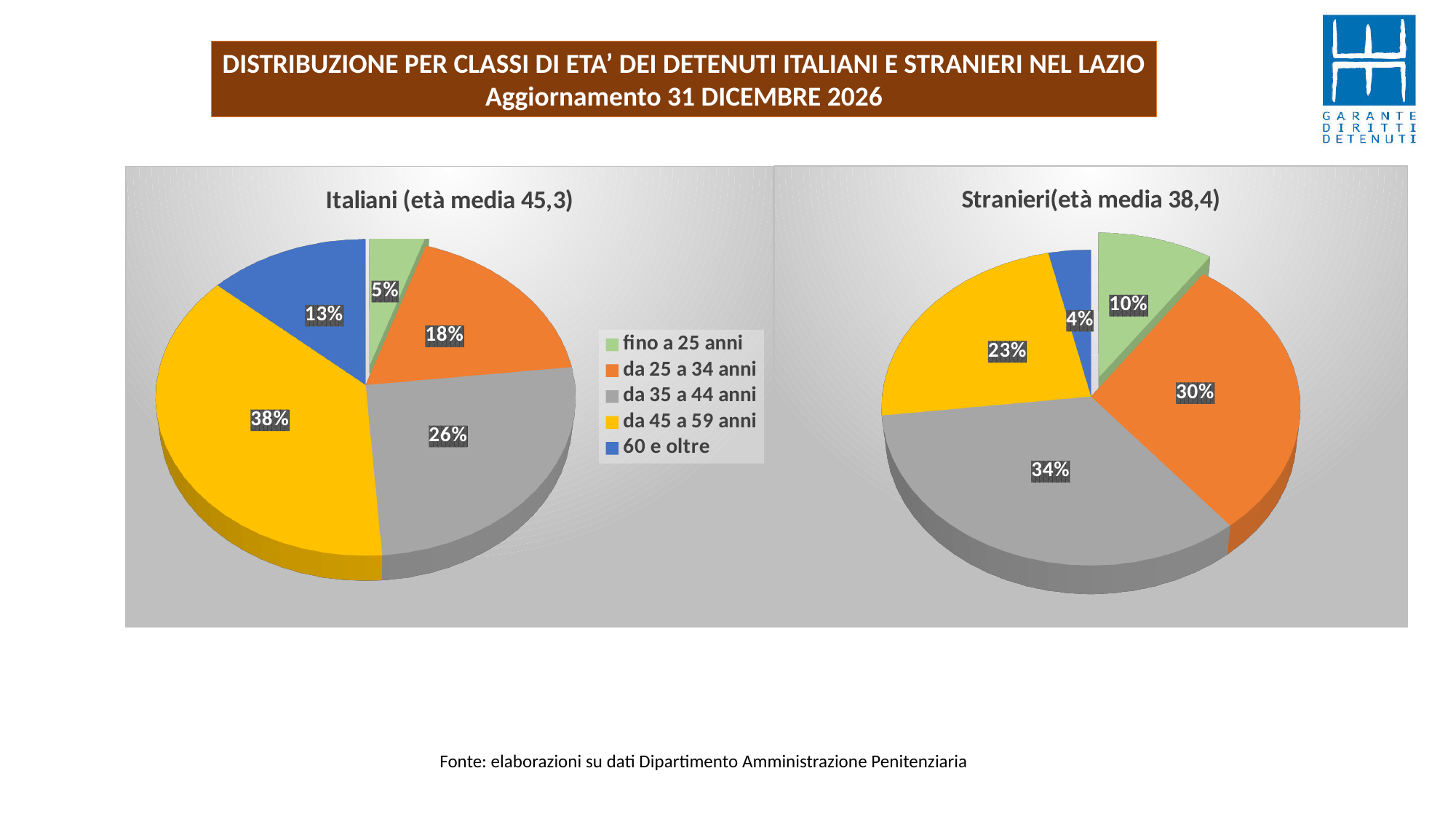
Which chart has the larger value for 'da 25 a 34 anni', 'Italiani (età media 45,3)' or 'Stranieri(età media 38,4)'? Stranieri(età media 38,4) How many age classes does the legend list? 5 What kind of chart is the 'Italiani (età media 45,3)' chart? Pie chart In the 'Italiani (età media 45,3)' chart, which age class has the largest slice? da 45 a 59 anni In the 'Stranieri(età media 38,4)' chart, what is the value for '60 e oltre'? 4% In the 'Stranieri(età media 38,4)' chart, which age class has the smallest slice? 60 e oltre In the 'Italiani (età media 45,3)' chart, what is the value for 'fino a 25 anni'? 5% In the 'Italiani (età media 45,3)' chart, what is the difference between 'da 45 a 59 anni' and 'da 35 a 44 anni'? 12% In the 'Italiani (età media 45,3)' chart, what share of the pie is 'da 45 a 59 anni'? 38% In the 'Stranieri(età media 38,4)' chart, what share of the pie is 'da 35 a 44 anni'? 34% In the 'Stranieri(età media 38,4)' chart, which age class has the largest slice? da 35 a 44 anni In the legend, which colour represents 'da 45 a 59 anni'? Yellow